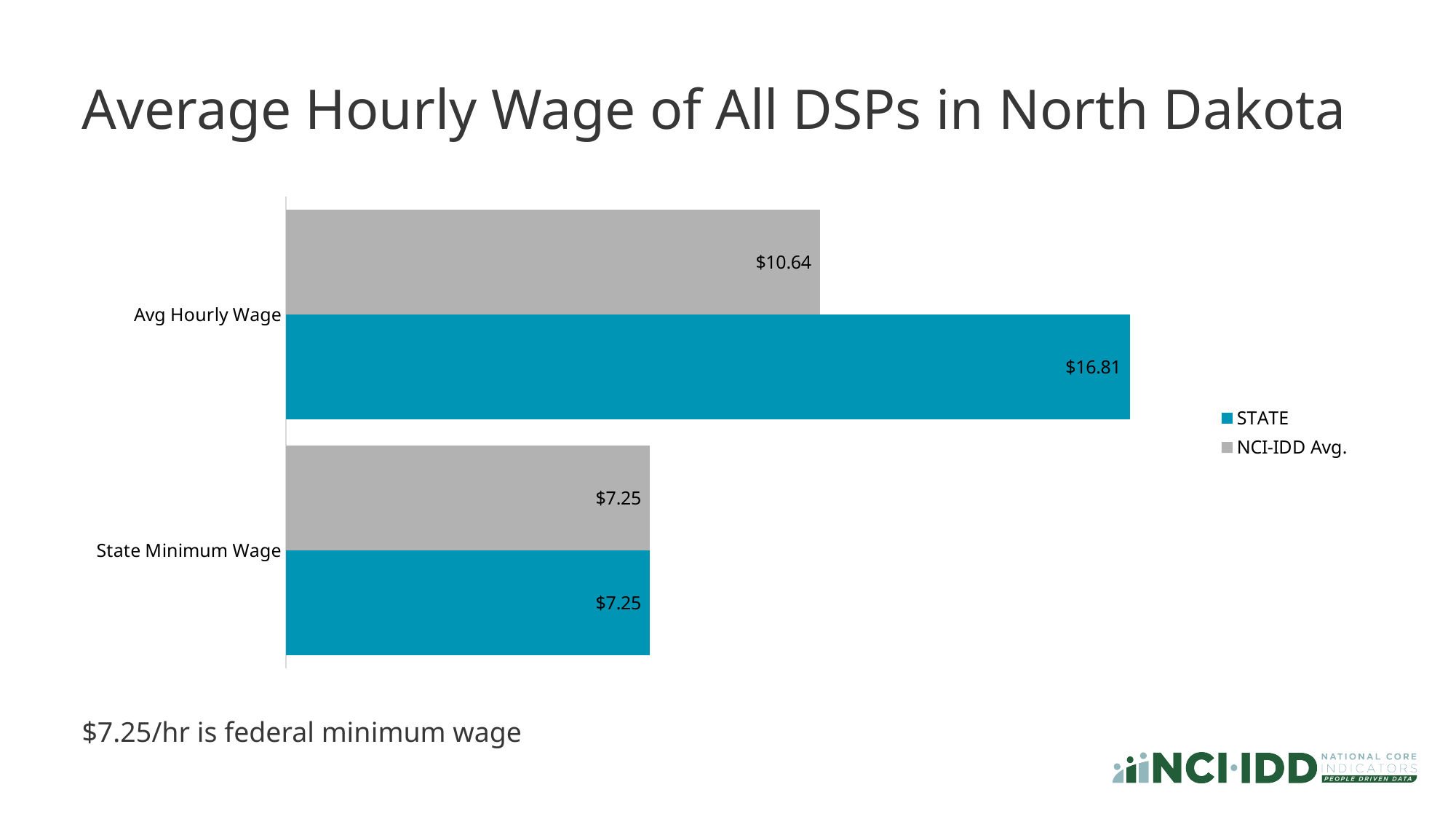
How many categories are shown on the chart? 2 Which bar in the chart has the highest value? STATE, Avg Hourly Wage What is the title of the chart? Average Hourly Wage of All DSPs in North Dakota What is the NCI-IDD Avg. value for State Minimum Wage? $7.25 What kind of chart is shown on the slide? Bar chart For Avg Hourly Wage, which is larger: the STATE value or the NCI-IDD Avg. value? STATE Which series is shown in grey in the legend? NCI-IDD Avg. What is the STATE value for Avg Hourly Wage? $16.81 What is the STATE value for State Minimum Wage? $7.25 What is the NCI-IDD Avg. value for Avg Hourly Wage? $10.64 What is the difference between the STATE and NCI-IDD Avg. values for Avg Hourly Wage? $6.17 How many series does the legend list? 2